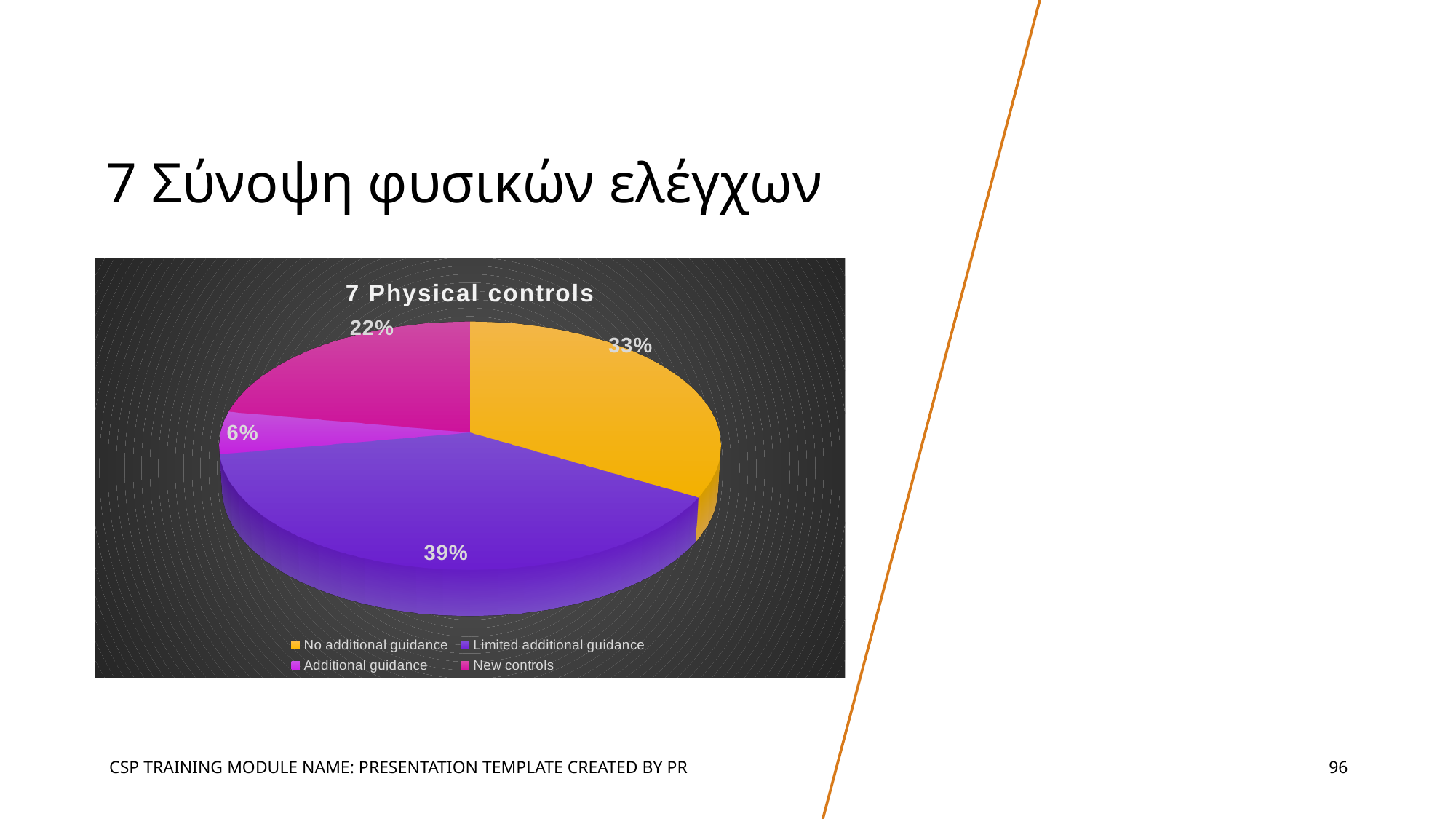
What is the difference in percentage points between 'Limited additional guidance' and 'No additional guidance'? 6 Which category has the largest share of the pie? Limited additional guidance What type of chart is shown on the slide? Pie chart How many slices does the pie chart have? 4 What percentage of the pie is 'Limited additional guidance'? 39% What is the title of the chart? 7 Physical controls What percentage of the pie is 'No additional guidance'? 33% Which category has the smallest share of the pie? Additional guidance Which is larger: the share for 'New controls' or the share for 'Additional guidance'? New controls Which colour represents 'No additional guidance' in the legend? Orange What percentage of the pie is 'New controls'? 22% What percentage of the pie is 'Additional guidance'? 6%